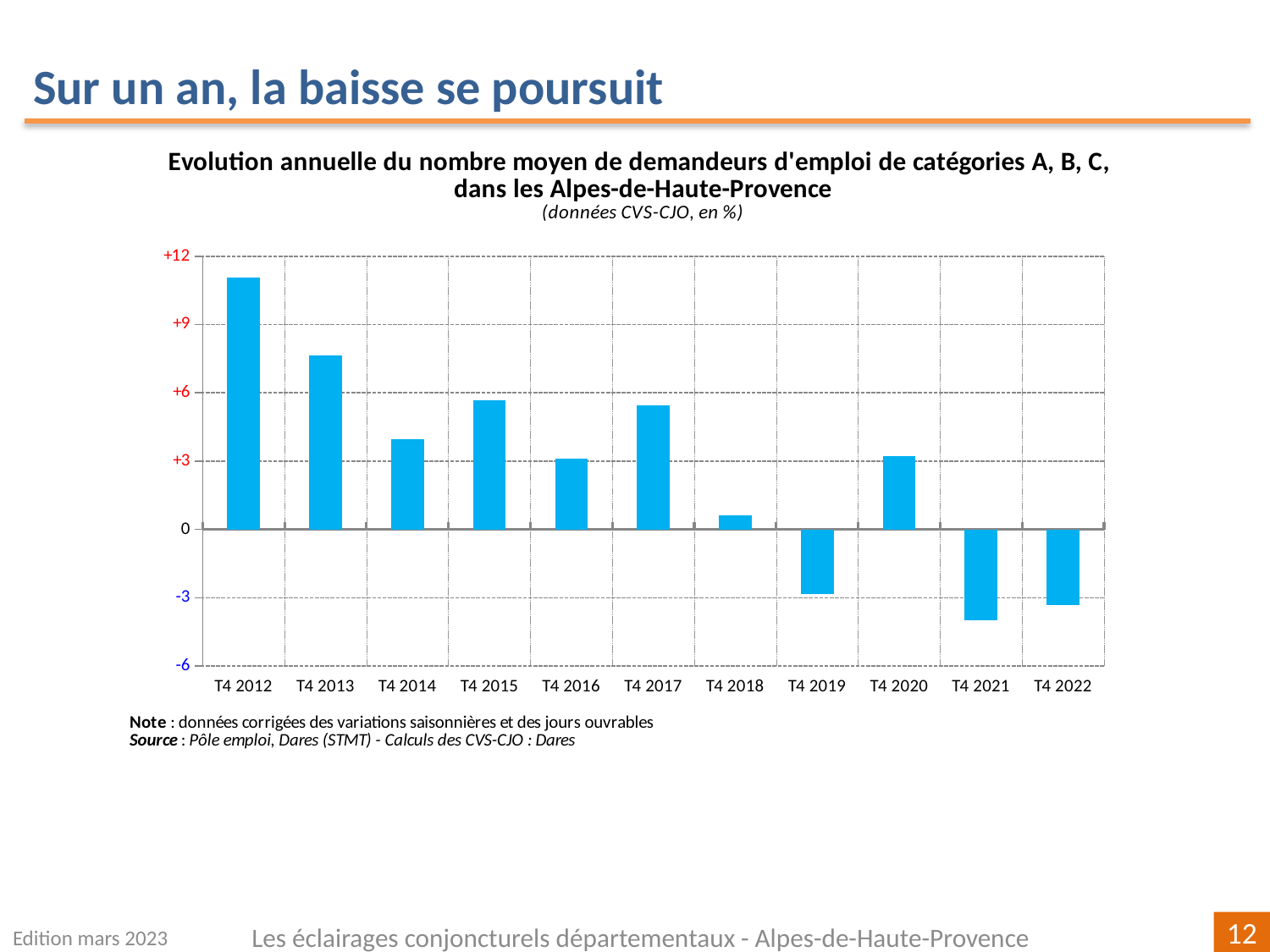
Which quarter has the highest value? T4 2012 Which is larger, the value for T4 2015 or the value for T4 2016? T4 2015 Is the value for T4 2018 greater or less than +3? less Is the value for T4 2021 greater or less than -3? less Which quarter has the lowest value? T4 2021 Which department does the chart title say the data refers to? Alpes-de-Haute-Provence Is the value for T4 2012 greater or less than +9? greater How many quarters (categories) are plotted on the x axis? 11 Which is larger, the value for T4 2020 or the value for T4 2022? T4 2020 What kind of chart is shown on the slide? bar chart